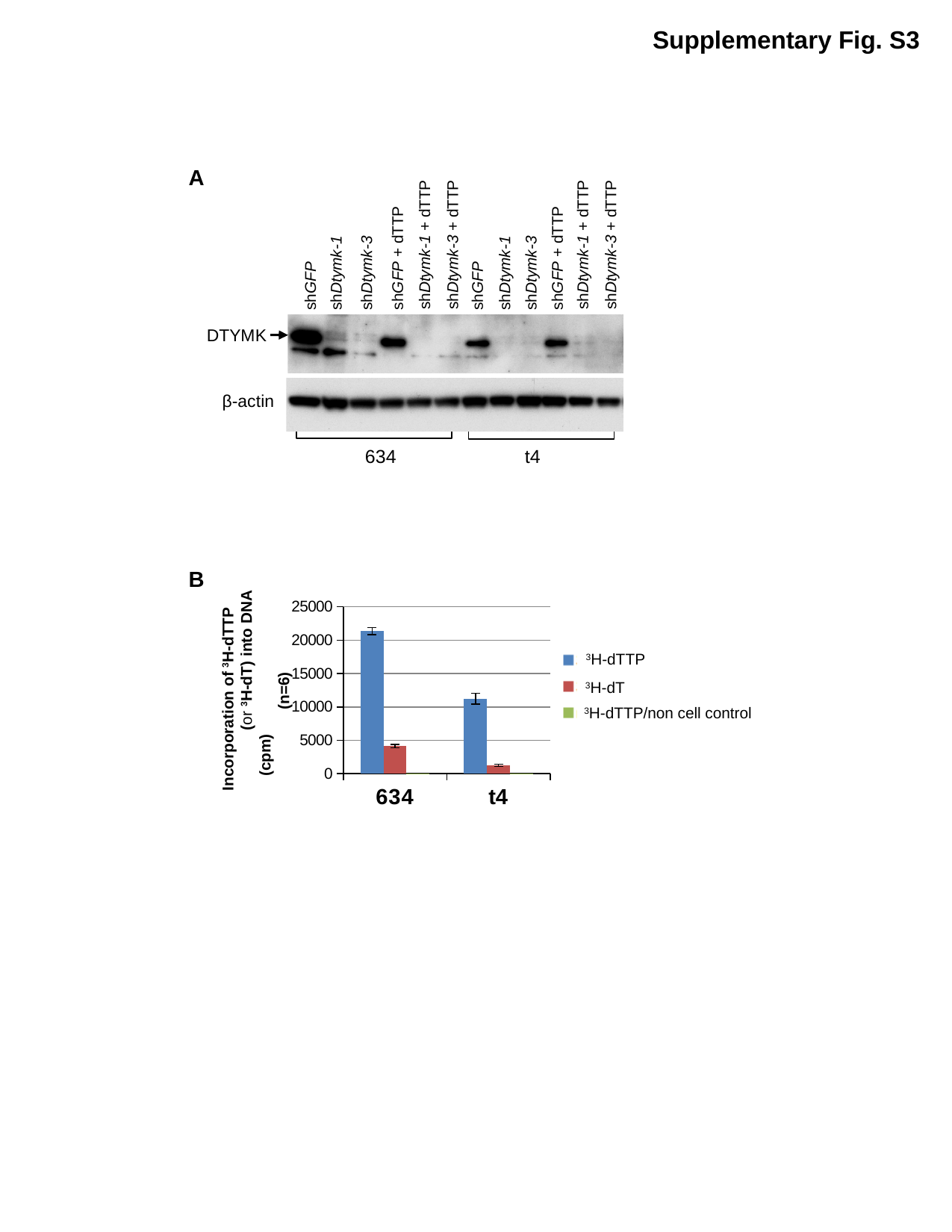
In the chart in panel B, which series is shown in blue? 3H-dTTP In the chart in panel B, which category has the higher 3H-dTTP value, 634 or t4? 634 In the chart in panel B, is the 3H-dTTP value for t4 greater or less than 15000? less In the chart in panel B, is the 3H-dTTP value for 634 greater or less than 20000? greater In the chart in panel B, which series has the lowest value for 634? 3H-dTTP/non cell control In the chart in panel B, which category has the highest 3H-dTTP incorporation? 634 In the chart in panel B, what kind of chart is shown? bar chart In the chart in panel B, how many series does the legend list? 3 In the chart in panel B, how many categories are shown on the x axis? 2 In the chart in panel B, is the 3H-dT value for 634 greater or less than 5000? less In the chart in panel B, for t4, which is larger, 3H-dTTP or 3H-dT? 3H-dTTP